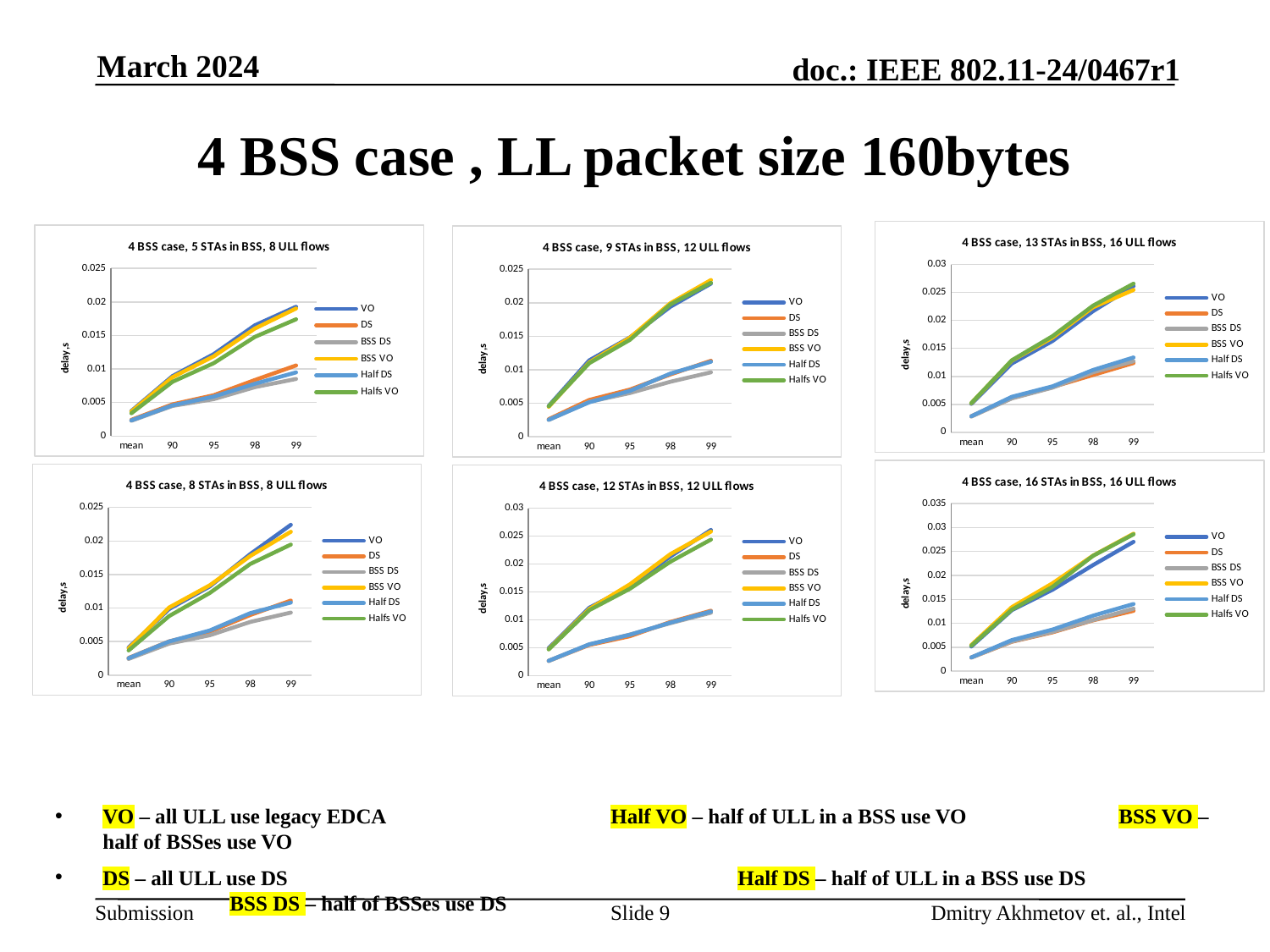
What kind of chart is the top-left chart titled '4 BSS case, 5 STAs in BSS, 8 ULL flows'? line chart What is the y-axis label of the bottom-middle chart '4 BSS case, 12 STAs in BSS, 12 ULL flows'? delay,s In the bottom-right chart '4 BSS case, 16 STAs in BSS, 16 ULL flows', is the value for DS at 99 greater or less than 0.015? less In the top-right chart '4 BSS case, 13 STAs in BSS, 16 ULL flows', is the value for VO at 99 greater or less than 0.02? greater In the bottom-left chart '4 BSS case, 8 STAs in BSS, 8 ULL flows', which is larger at 99: VO or Halfs VO? VO What is the title of the top-right chart on the slide? 4 BSS case, 13 STAs in BSS, 16 ULL flows In the bottom-left chart '4 BSS case, 8 STAs in BSS, 8 ULL flows', is the value for DS at 'mean' greater or less than 0.005? less In the top-left chart '4 BSS case, 5 STAs in BSS, 8 ULL flows', how many series does the legend list? 6 In the top-left chart '4 BSS case, 5 STAs in BSS, 8 ULL flows', which is larger at 99: VO or DS? VO In the top-left chart '4 BSS case, 5 STAs in BSS, 8 ULL flows', does the VO series rise or fall from 'mean' to '99'? rise In the bottom-right chart '4 BSS case, 16 STAs in BSS, 16 ULL flows', how many categories are shown on the x axis? 5